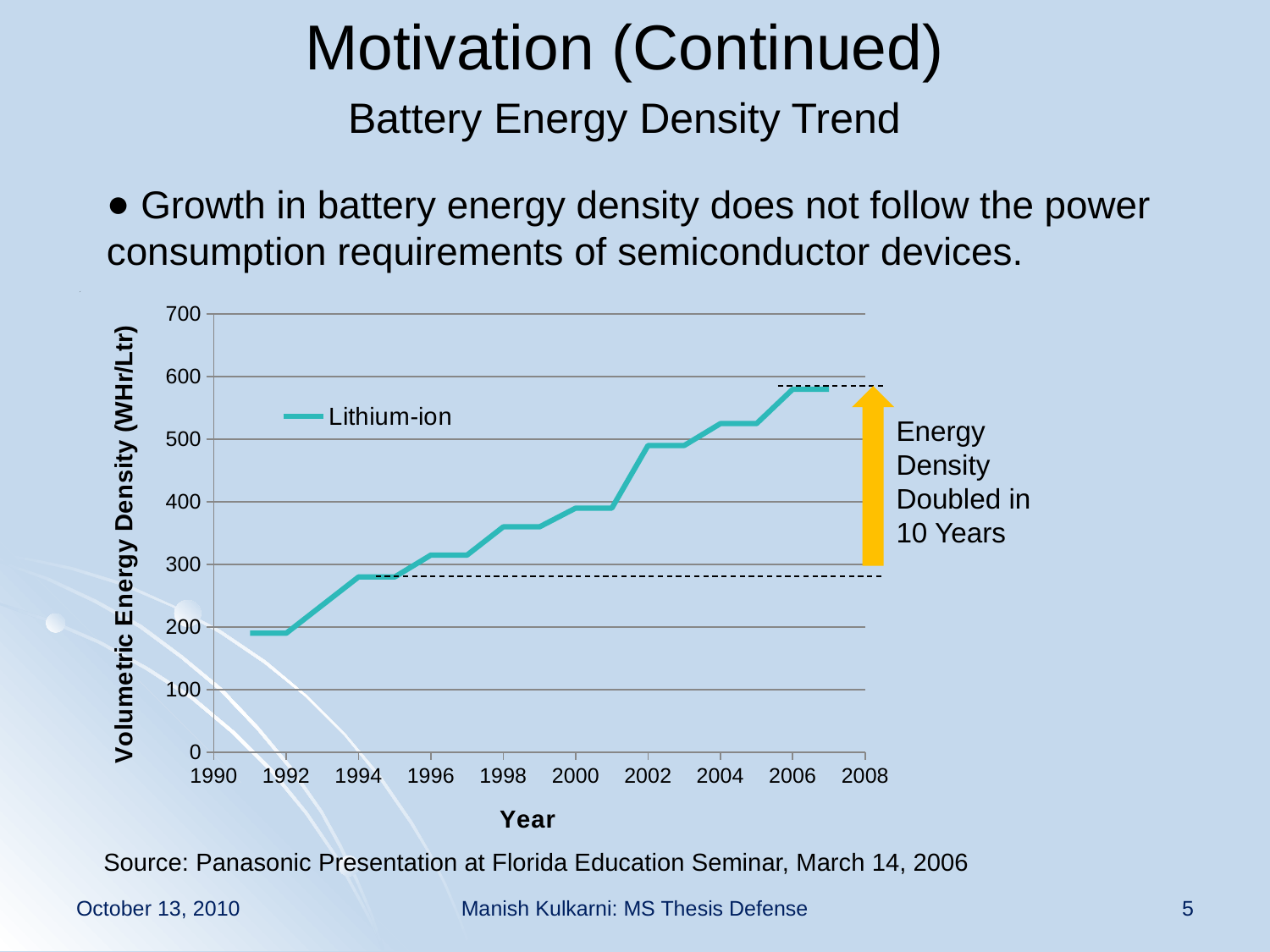
What series is listed in the chart's legend? Lithium-ion Is the Lithium-ion value for 1994 greater or less than 400? less Is the Lithium-ion value for 1998 greater or less than 300? greater Is the Lithium-ion value for 2006 greater or less than 500? greater Which is larger, the Lithium-ion value for 2006 or for 1996? 2006 What is the label of the chart's y axis? Volumetric Energy Density (WHr/Ltr) What kind of chart is shown on the slide? line chart How many series does the chart's legend list? 1 Do the Lithium-ion values rise or fall from 1990 to 2008? rise